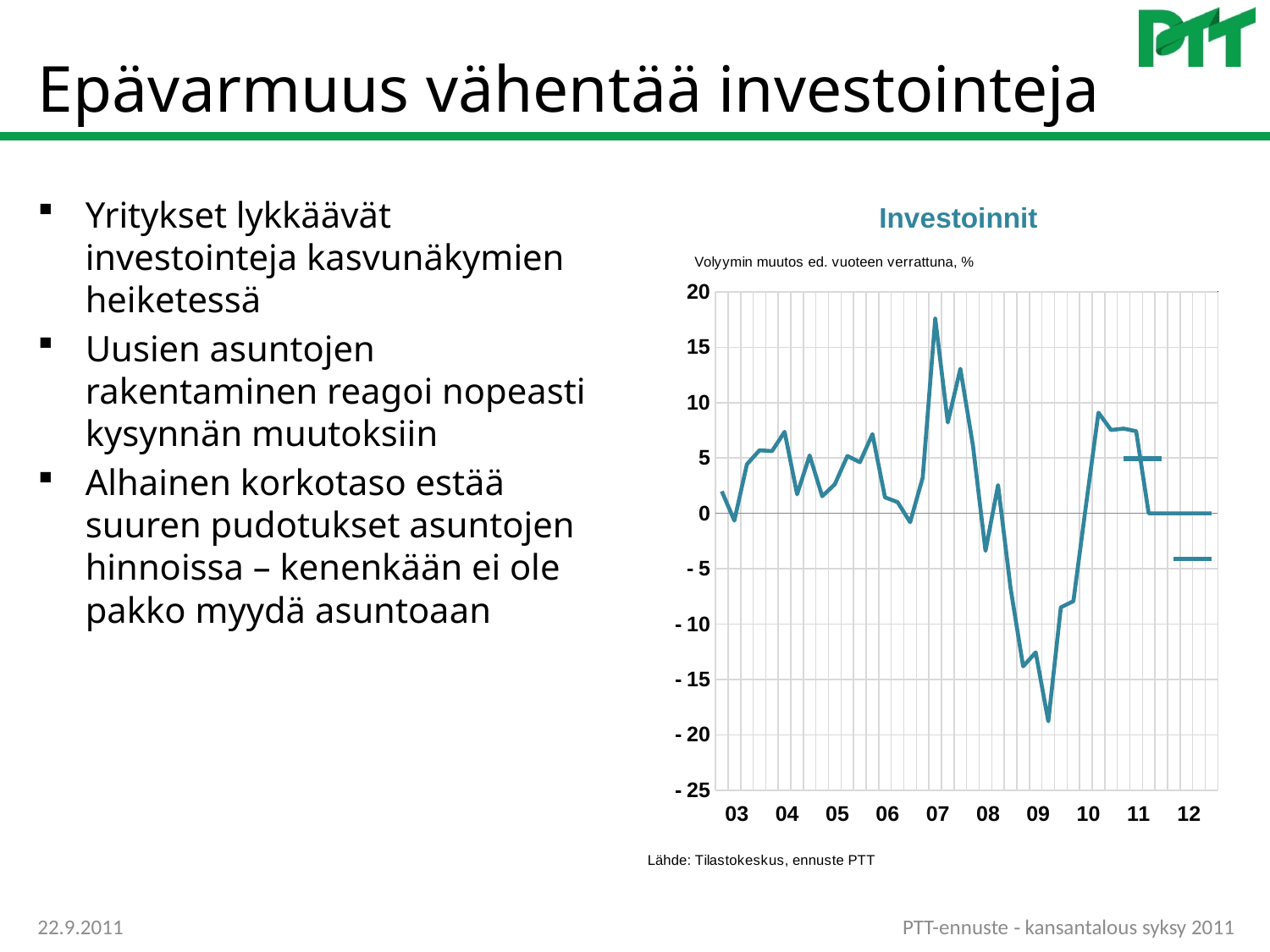
What kind of chart is shown on the slide? line chart What is the title of the chart? Investoinnit Is the lowest value of the line, reached around 09, greater or less than -15? less Between 08 and early 09, do the values rise or fall? fall In which year does the line reach its lowest point? 09 Between 09 and 10, do the values rise or fall? rise Is the highest value of the line, reached around 07, greater or less than 15? greater In which year does the line reach its highest point? 07 How many year labels are shown on the x axis of the chart? 10 What unit or measure does the chart's subtitle say is plotted? Volyymin muutos ed. vuoteen verrattuna, %